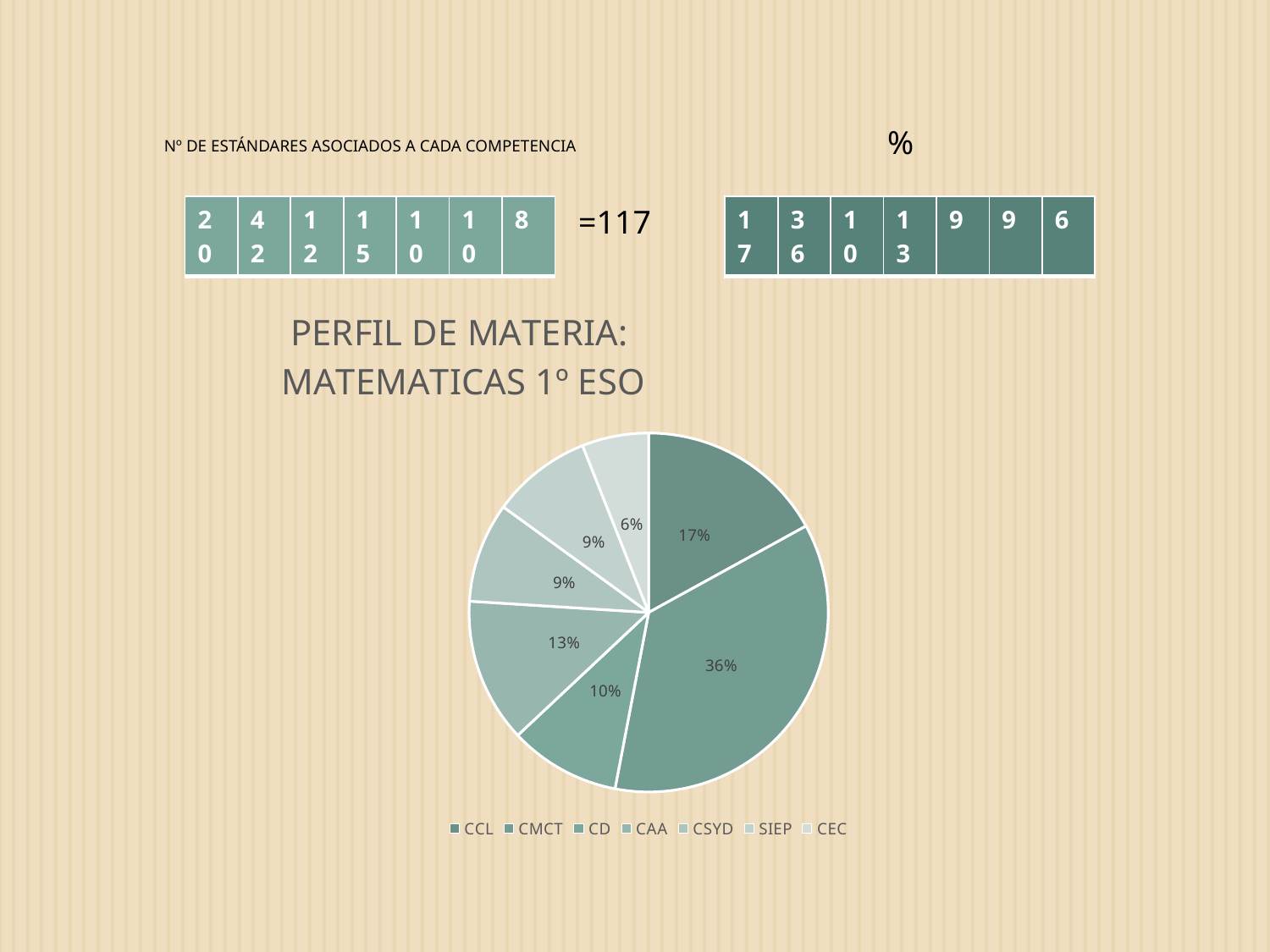
How many entries does the legend list? 7 What share of the pie does CMCT represent? 36% What kind of chart is shown on the slide? pie chart Which competence has the largest slice of the pie? CMCT What is the difference in percentage points between the CMCT slice and the CCL slice? 19 What share of the pie does CEC represent? 6% What share of the pie does CAA represent? 13% Which competence has the smallest slice of the pie? CEC How many slices does the pie chart have? 7 What is the title of the chart? PERFIL DE MATERIA: MATEMATICAS 1º ESO Which slice is larger, CAA or CD? CAA